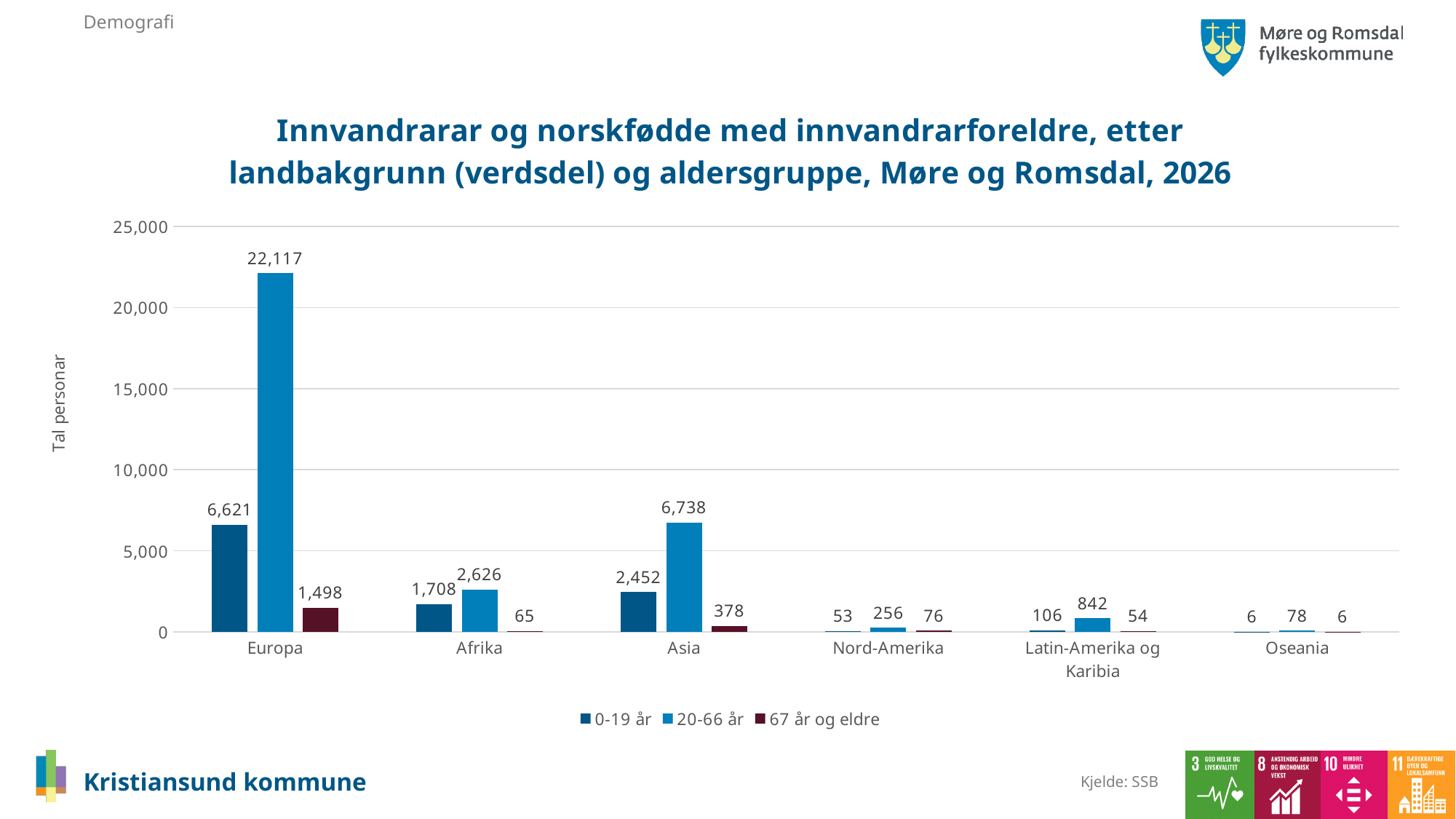
What is the value for the 67 år og eldre series for Afrika? 65 What is the value for the 20-66 år series for Europa? 22,117 Which category has the lowest value for the 0-19 år series? Oseania Which is larger: the 0-19 år value for Europa or the 20-66 år value for Asia? 20-66 år value for Asia What is the value for the 0-19 år series for Asia? 2,452 Is the value for the 20-66 år series for Europa greater or less than 20,000? greater What is the difference between the 20-66 år value for Asia and the 20-66 år value for Afrika? 4,112 What kind of chart is shown on the slide? bar chart Which category has the highest value for the 20-66 år series? Europa How many categories are shown on the x axis? 6 What is the value for the 20-66 år series for Latin-Amerika og Karibia? 842 How many series does the legend list? 3